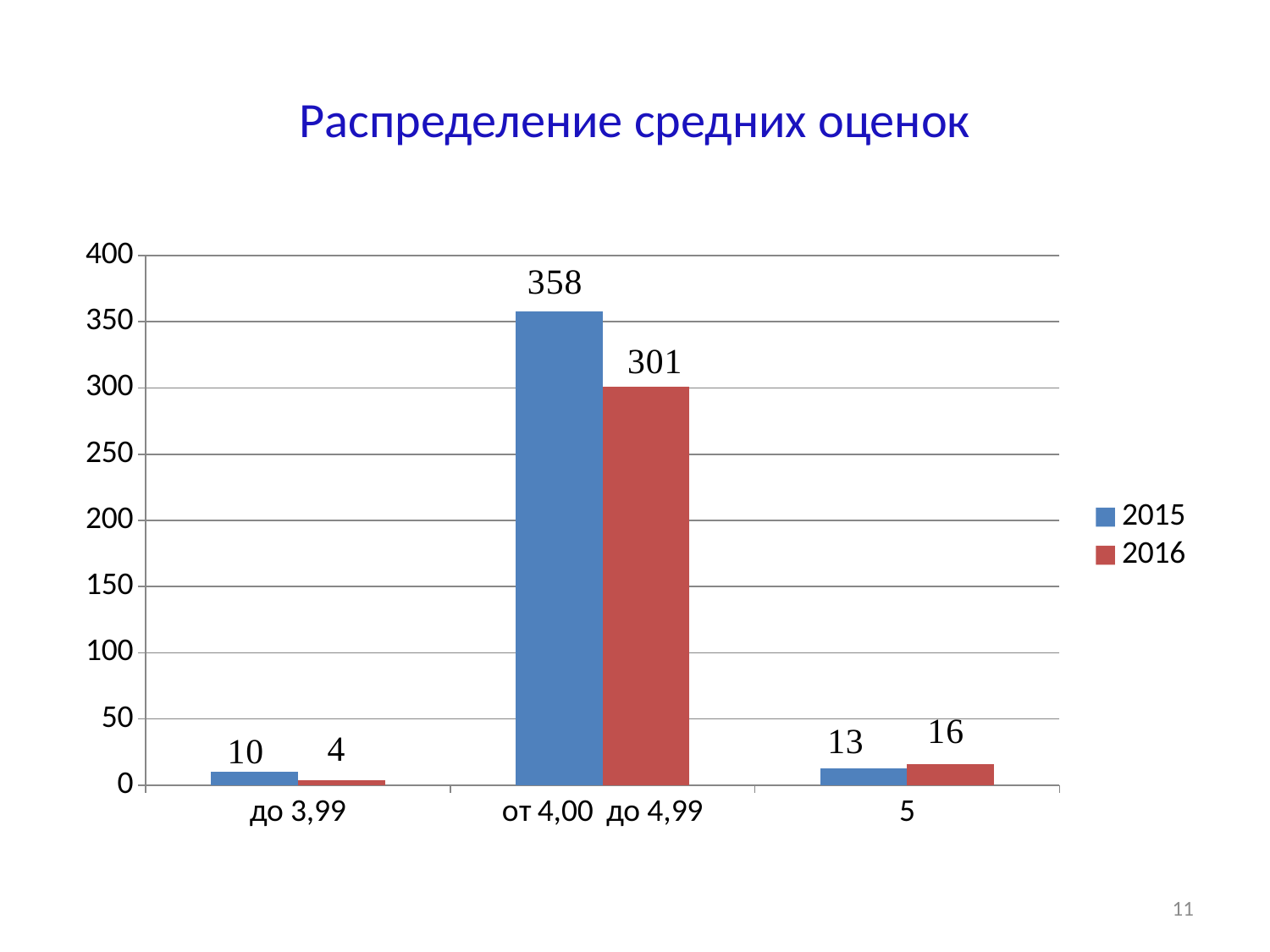
What is the title of the chart? Распределение средних оценок How many series does the legend list? 2 What is the value for 2016 in the category "до 3,99"? 4 Is the value for 2016 in the category "от 4,00 до 4,99" greater or less than 350? less Which category has the highest value for 2016? от 4,00 до 4,99 What kind of chart is shown on the slide? bar chart What is the value for 2015 in the category "от 4,00 до 4,99"? 358 What is the difference between the 2015 and 2016 values in the category "от 4,00 до 4,99"? 57 In the category "5", which series has the larger value, 2015 or 2016? 2016 Which category has the lowest value for 2015? до 3,99 How many categories are shown on the x axis? 3 What is the value for 2016 in the category "5"? 16